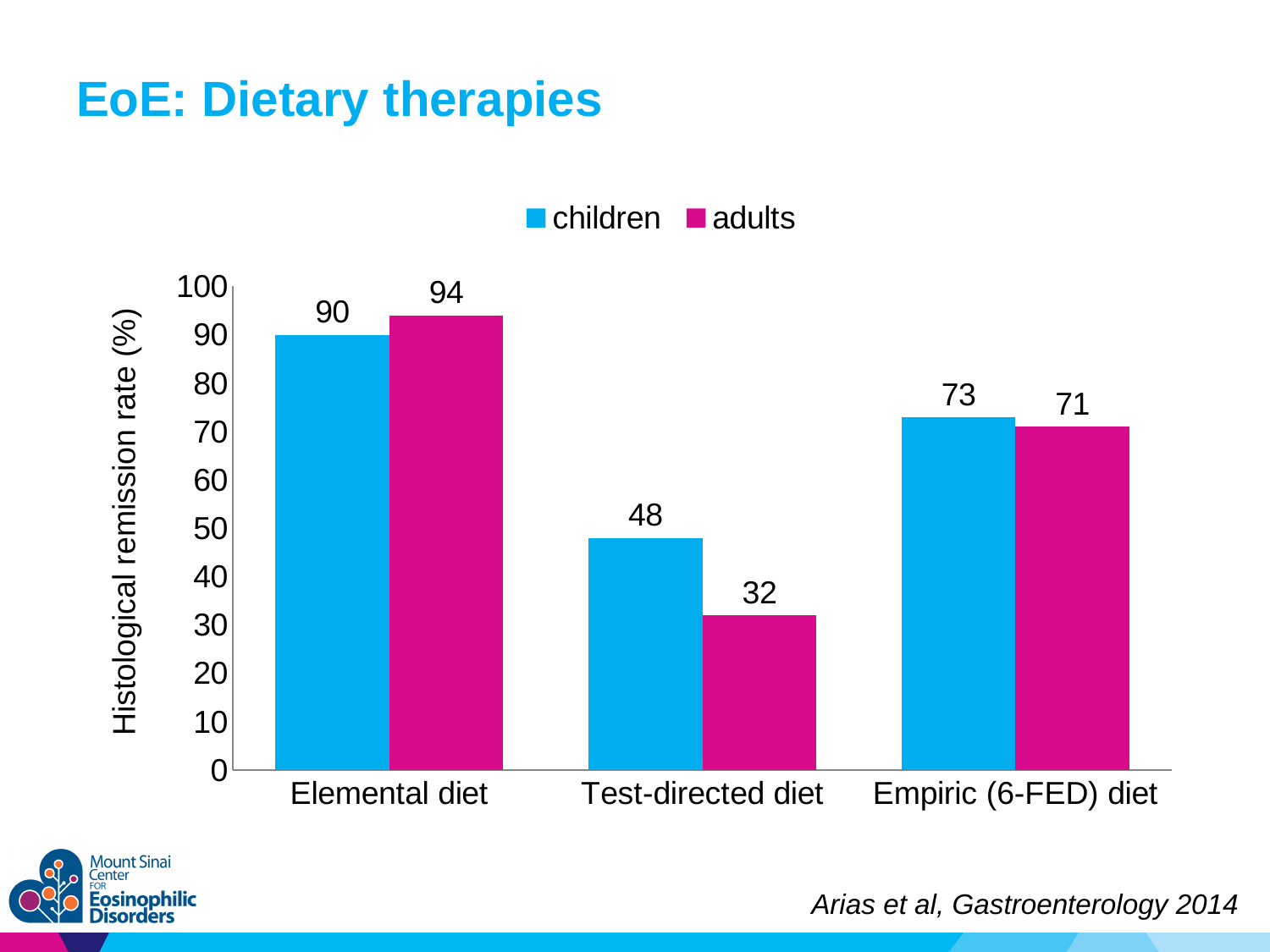
What is the histological remission rate for adults on the Test-directed diet? 32 Is the children's remission rate for the Empiric (6-FED) diet greater or less than 60? greater What is the difference between the adults remission rates for the Elemental diet and the Empiric (6-FED) diet? 23 What kind of chart is shown on the slide? bar chart What is the histological remission rate for adults on the Empiric (6-FED) diet? 71 How many diet categories are shown on the x axis? 3 For the Elemental diet, which group has the higher remission rate, children or adults? adults Which diet has the highest histological remission rate for adults? Elemental diet What is the histological remission rate for children on the Elemental diet? 90 Which diet has the lowest histological remission rate for children? Test-directed diet What is the difference between the children and adults remission rates for the Test-directed diet? 16 How many series does the legend list? 2